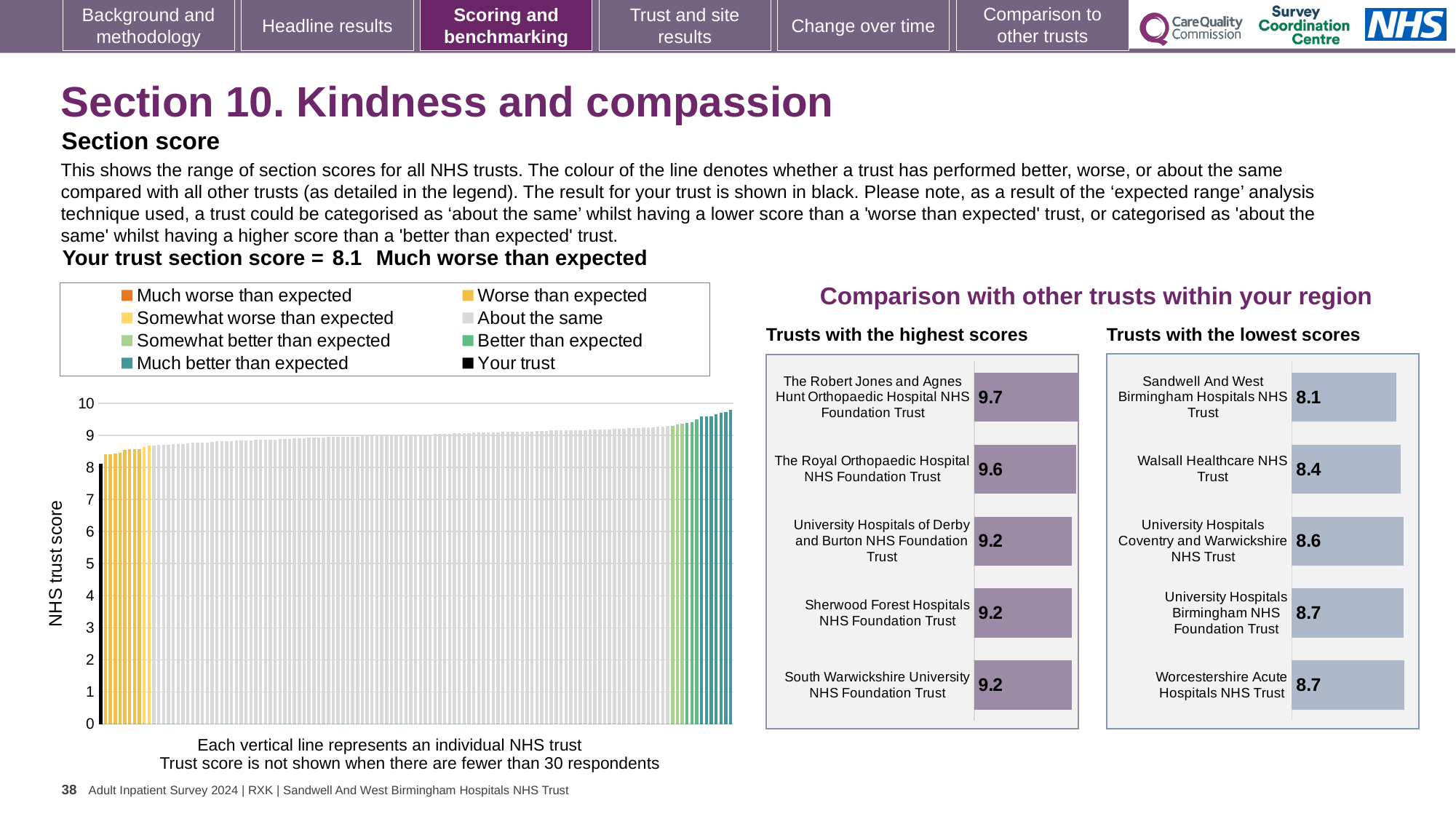
In the 'Trusts with the lowest scores' chart, which has the higher score: Walsall Healthcare NHS Trust or University Hospitals Coventry and Warwickshire NHS Trust? University Hospitals Coventry and Warwickshire NHS Trust In the 'Trusts with the lowest scores' chart, what is the score for Walsall Healthcare NHS Trust? 8.4 What kind of chart is the large 'NHS trust score' chart on the left of the slide? bar chart In the 'Trusts with the lowest scores' chart, which trust has the lowest score? Sandwell And West Birmingham Hospitals NHS Trust In the 'NHS trust score' chart on the left, is the value for the black 'Your trust' bar greater or less than 9? less In the legend of the 'NHS trust score' chart on the left, what colour represents 'Your trust'? black How many entries does the legend of the 'NHS trust score' chart on the left list? 8 In the 'Trusts with the highest scores' chart, what is the score for The Robert Jones and Agnes Hunt Orthopaedic Hospital NHS Foundation Trust? 9.7 In the 'Trusts with the lowest scores' chart, what is the difference between the scores of Worcestershire Acute Hospitals NHS Trust and Sandwell And West Birmingham Hospitals NHS Trust? 0.6 In the 'Trusts with the highest scores' chart, what is the difference between the scores of The Robert Jones and Agnes Hunt Orthopaedic Hospital NHS Foundation Trust and The Royal Orthopaedic Hospital NHS Foundation Trust? 0.1 How many trusts are shown in the 'Trusts with the highest scores' chart? 5 In the 'Trusts with the highest scores' chart, which trust has the highest score? The Robert Jones and Agnes Hunt Orthopaedic Hospital NHS Foundation Trust